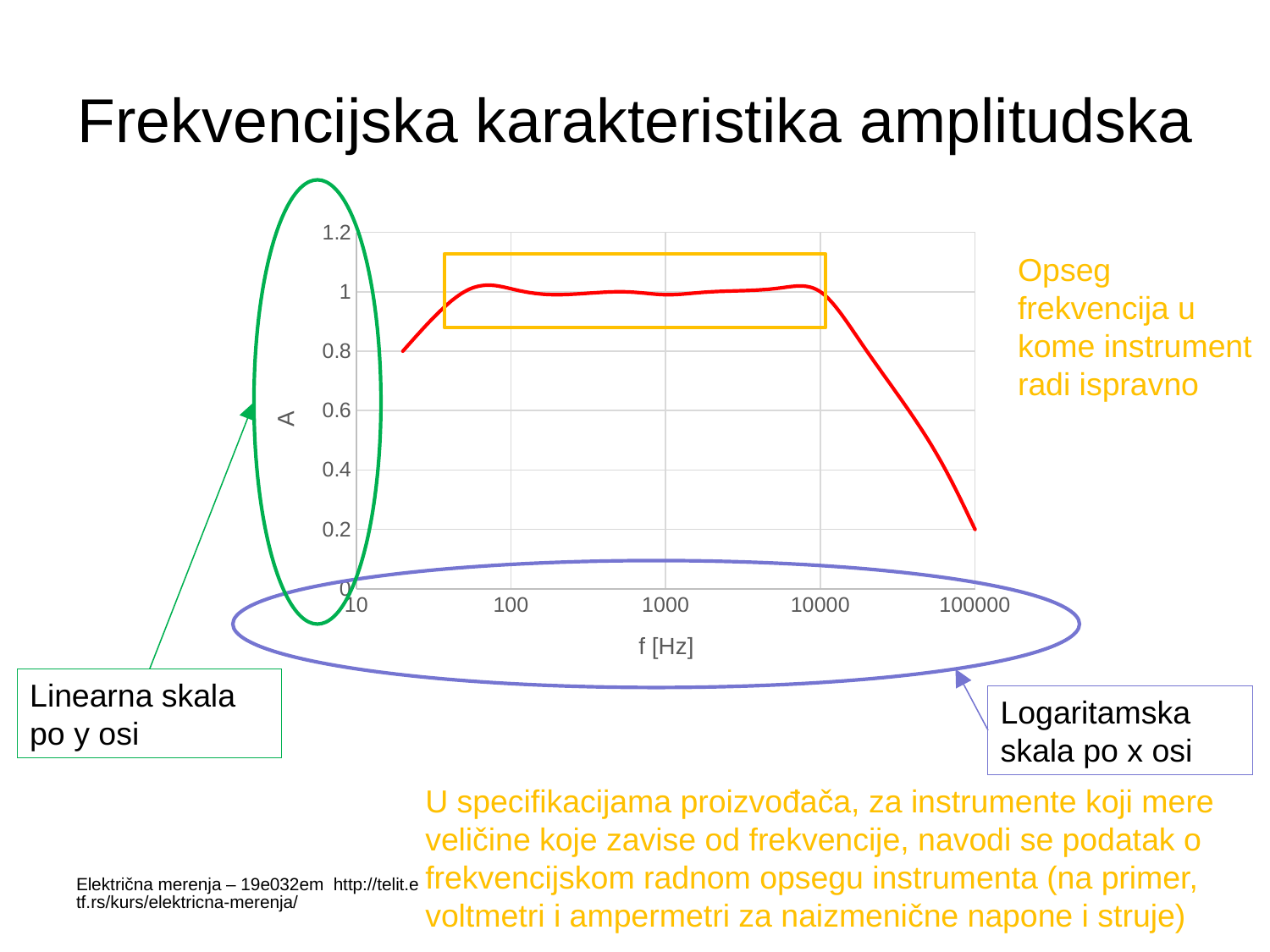
What kind of chart is shown on the slide? line chart What is the highest tick value shown on the y axis? 1.2 Is the value of A at 100000 Hz greater or less than 0.4? less Is the value of A at 100 Hz greater or less than 1.2? less Which is larger, the value of A at 100 Hz or at 20 Hz? 100 Hz Does the value of A rise or fall as f increases from 20 Hz to 100 Hz? rise What is the label of the y axis of the chart? A Does the value of A rise or fall as f increases from 10000 Hz to 100000 Hz? fall What is the label of the x axis of the chart? f [Hz] Is the value of A at 1000 Hz greater or less than 0.8? greater Which is larger, the value of A at 1000 Hz or at 100000 Hz? 1000 Hz